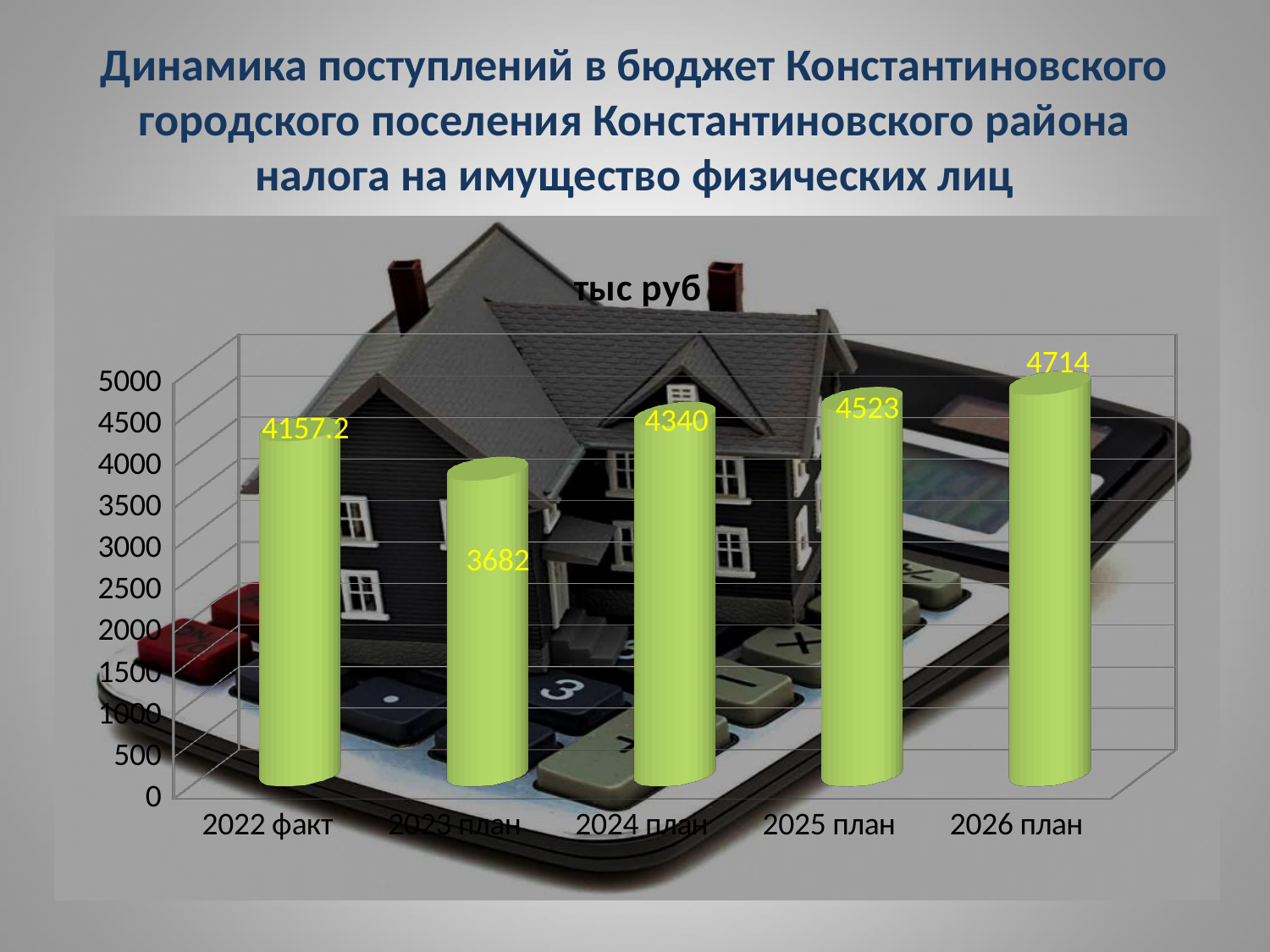
Which category has the highest value? 2026 план What is the difference between the values for 2026 план and 2025 план? 191 What is the value for 2025 план? 4523 What is the value for 2023 план? 3682 What is the title shown above the chart area? тыс руб What is the value for 2022 факт? 4157.2 What is the value for 2026 план? 4714 Which is larger, the value for 2022 факт or the value for 2024 план? 2024 план How many categories are shown on the x axis? 5 What is the value for 2024 план? 4340 What kind of chart is shown on the slide? bar chart Which category has the lowest value? 2023 план